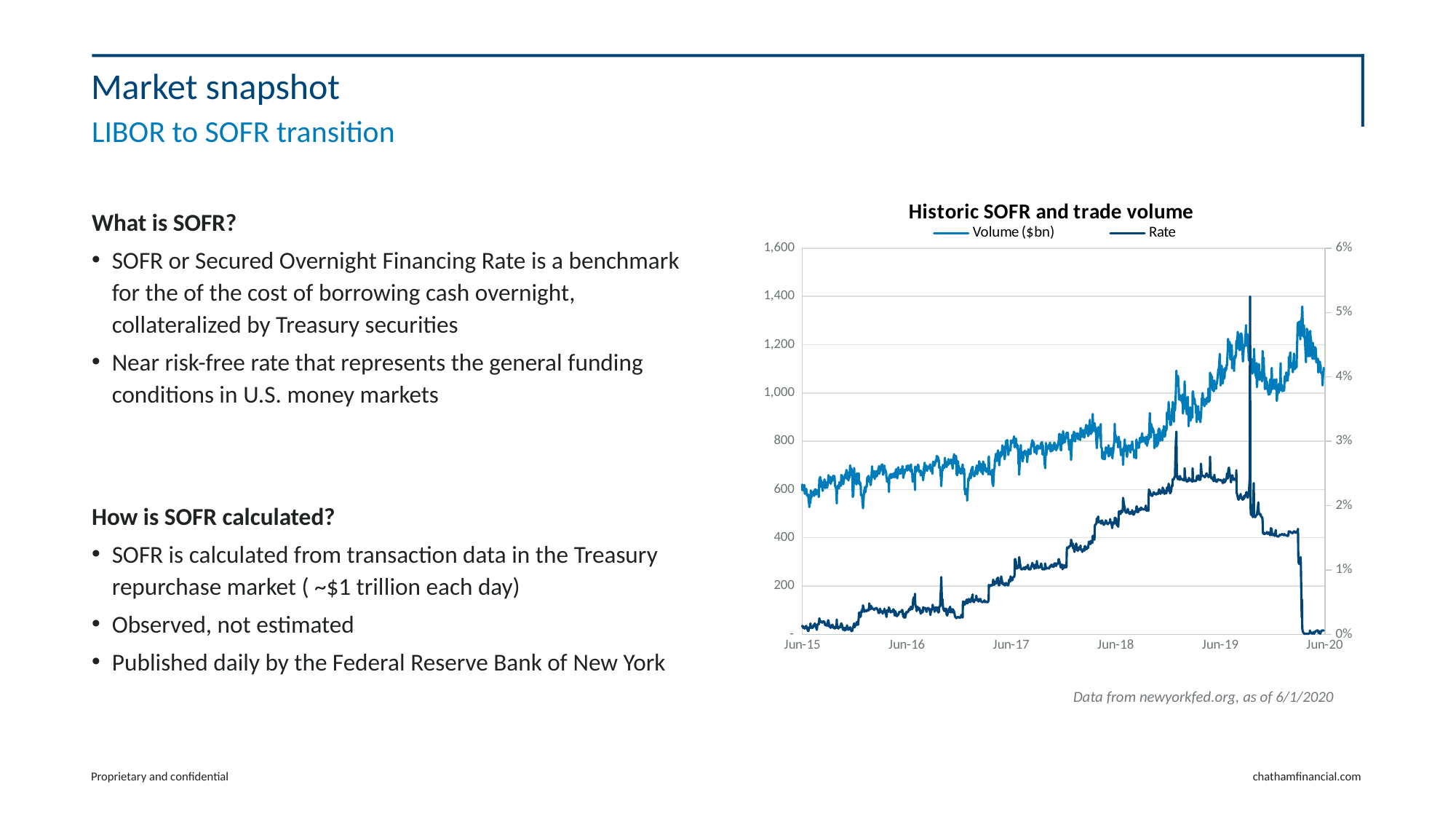
Is the Volume ($bn) value at Jun-15 greater or less than 400? greater Does the Rate series rise or fall between Jun-19 and Jun-20? Fall How many series does the legend of the chart list? 2 What is the title of the chart? Historic SOFR and trade volume What are the two series named in the chart legend? Volume ($bn) and Rate Is the Rate value at Jun-20 greater or less than 1%? less What is the highest value shown on the left-hand axis of the chart? 1,600 Is the Volume ($bn) value at Jun-19 greater or less than 800? greater What kind of chart is shown on the slide? Line chart How many date labels are shown on the x axis of the chart? 6 Does the Volume ($bn) series generally rise or fall from Jun-15 to Jun-20? Rise